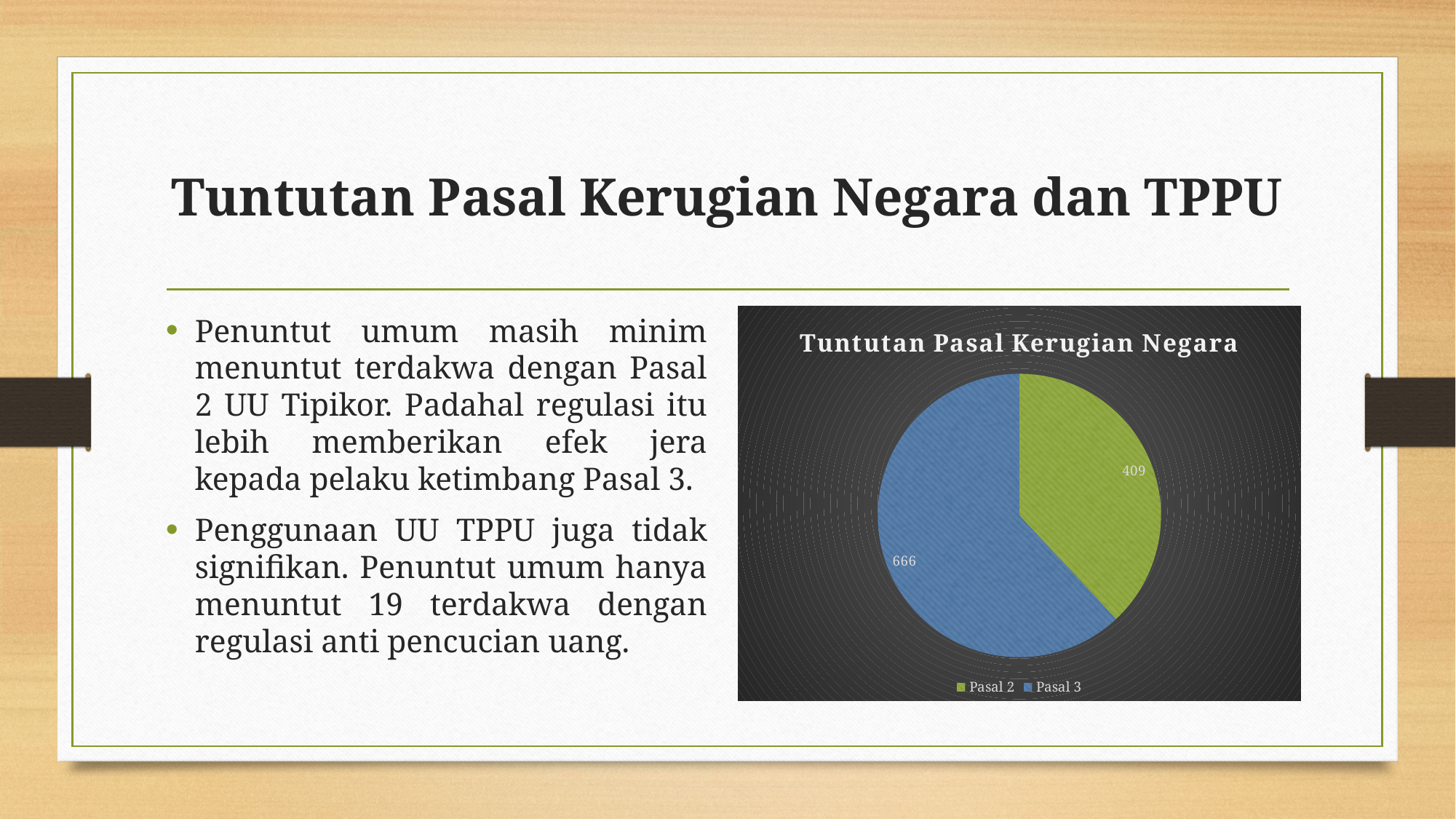
Which category has the smallest slice? Pasal 2 What is the difference between the values for Pasal 3 and Pasal 2? 257 Which category has the largest slice? Pasal 3 Which is larger, Pasal 2 or Pasal 3? Pasal 3 What is the total of the two slices? 1075 Which colour represents Pasal 3 in the chart? blue What is the value for Pasal 3? 666 How many slices does the pie chart have? 2 What type of chart is shown on the slide? pie chart What is the value for Pasal 2? 409 How many entries does the legend list? 2 What is the title of the chart? Tuntutan Pasal Kerugian Negara